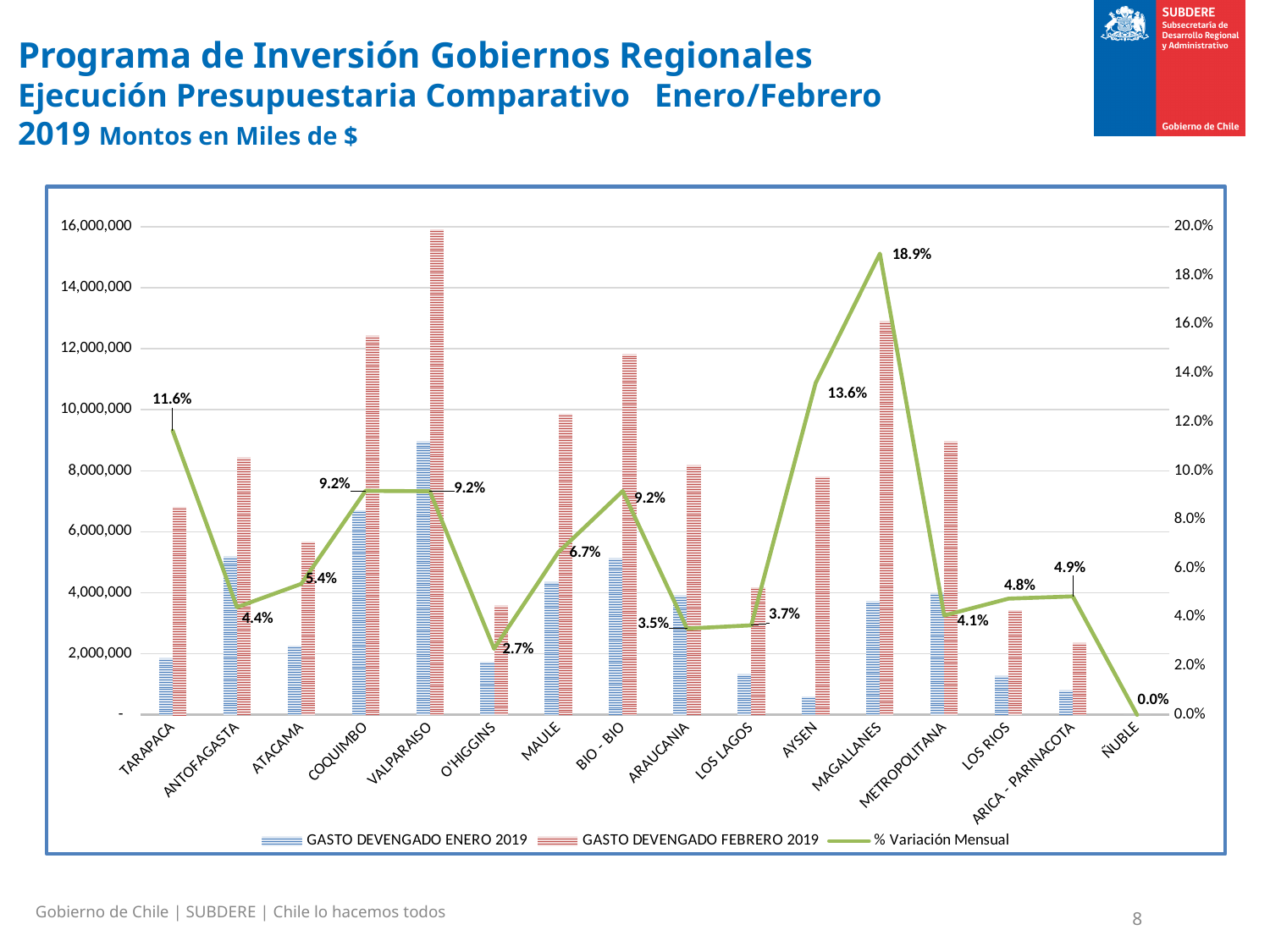
Which region has the highest % Variación Mensual? MAGALLANES Which region has the lowest % Variación Mensual? ÑUBLE Which has a higher % Variación Mensual, TARAPACA or AYSEN? AYSEN What is the % Variación Mensual value for O'HIGGINS? 2.7% How many regions are shown on the x axis? 16 What is the % Variación Mensual value for AYSEN? 13.6% How many series does the legend list? 3 Is the GASTO DEVENGADO FEBRERO 2019 value for VALPARAISO greater or less than 14,000,000? greater What is the % Variación Mensual value for MAGALLANES? 18.9% What is the difference in % Variación Mensual between MAGALLANES and AYSEN? 5.3 percentage points Which region has the highest GASTO DEVENGADO FEBRERO 2019 bar? VALPARAISO